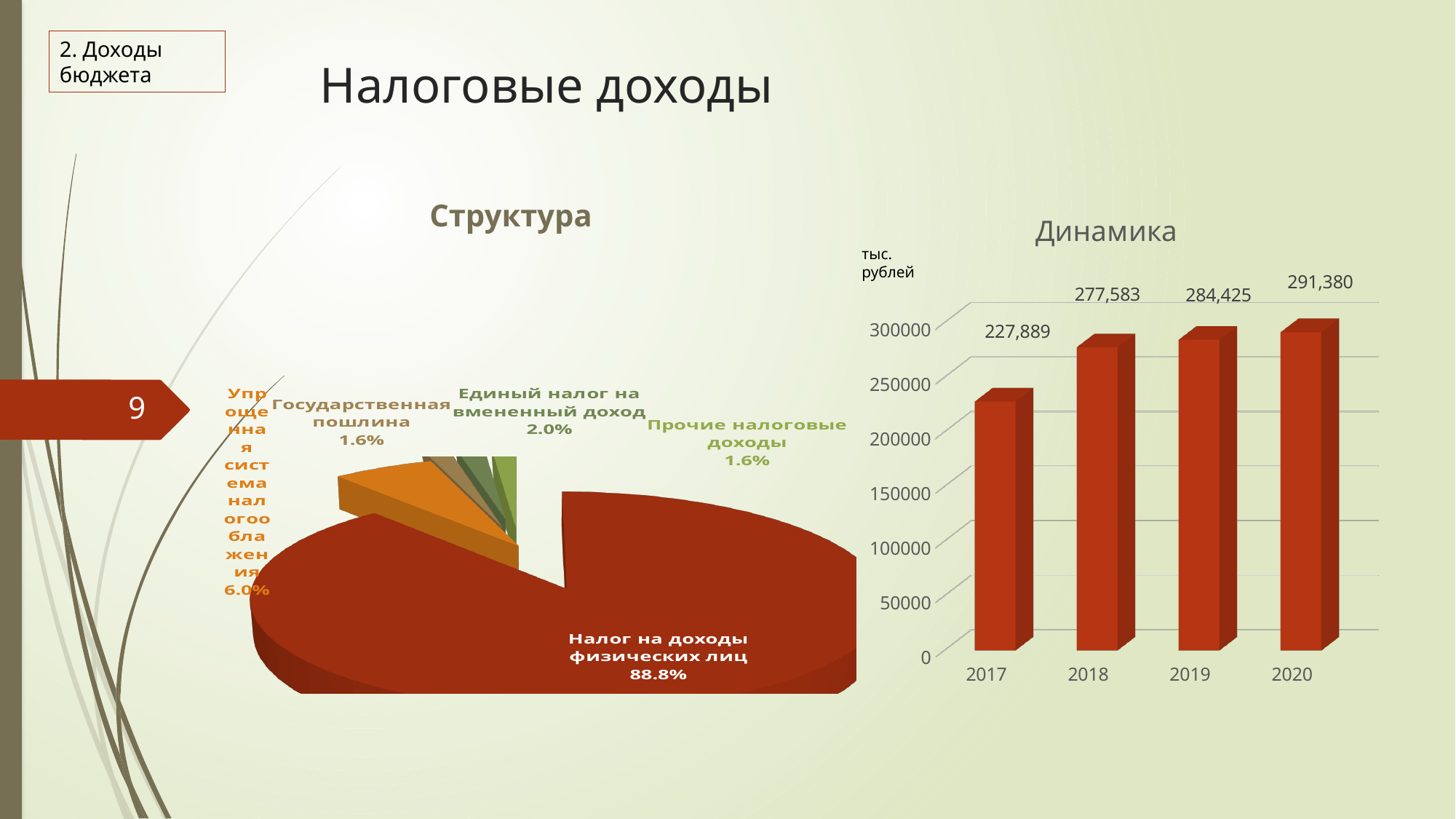
How many years are shown in the 'Динамика' chart? 4 In the 'Динамика' chart, is the value for 2019 greater or less than 250000? greater In the 'Структура' pie chart, what share does 'Налог на доходы физических лиц' have? 88.8% In the 'Динамика' chart, what is the difference between the values for 2018 and 2017? 49,694 In the 'Динамика' chart, which year has the highest value? 2020 In the 'Динамика' chart, which year has the lowest value? 2017 What kind of chart is the 'Структура' chart? pie chart In the 'Структура' pie chart, which slice is the largest? Налог на доходы физических лиц In the 'Динамика' chart, what is the value for 2017? 227,889 In the 'Динамика' chart, do the values rise or fall from 2017 to 2020? rise In the 'Динамика' chart, what is the value for 2020? 291,380 In the 'Структура' pie chart, what share does 'Единый налог на вмененный доход' have? 2.0%